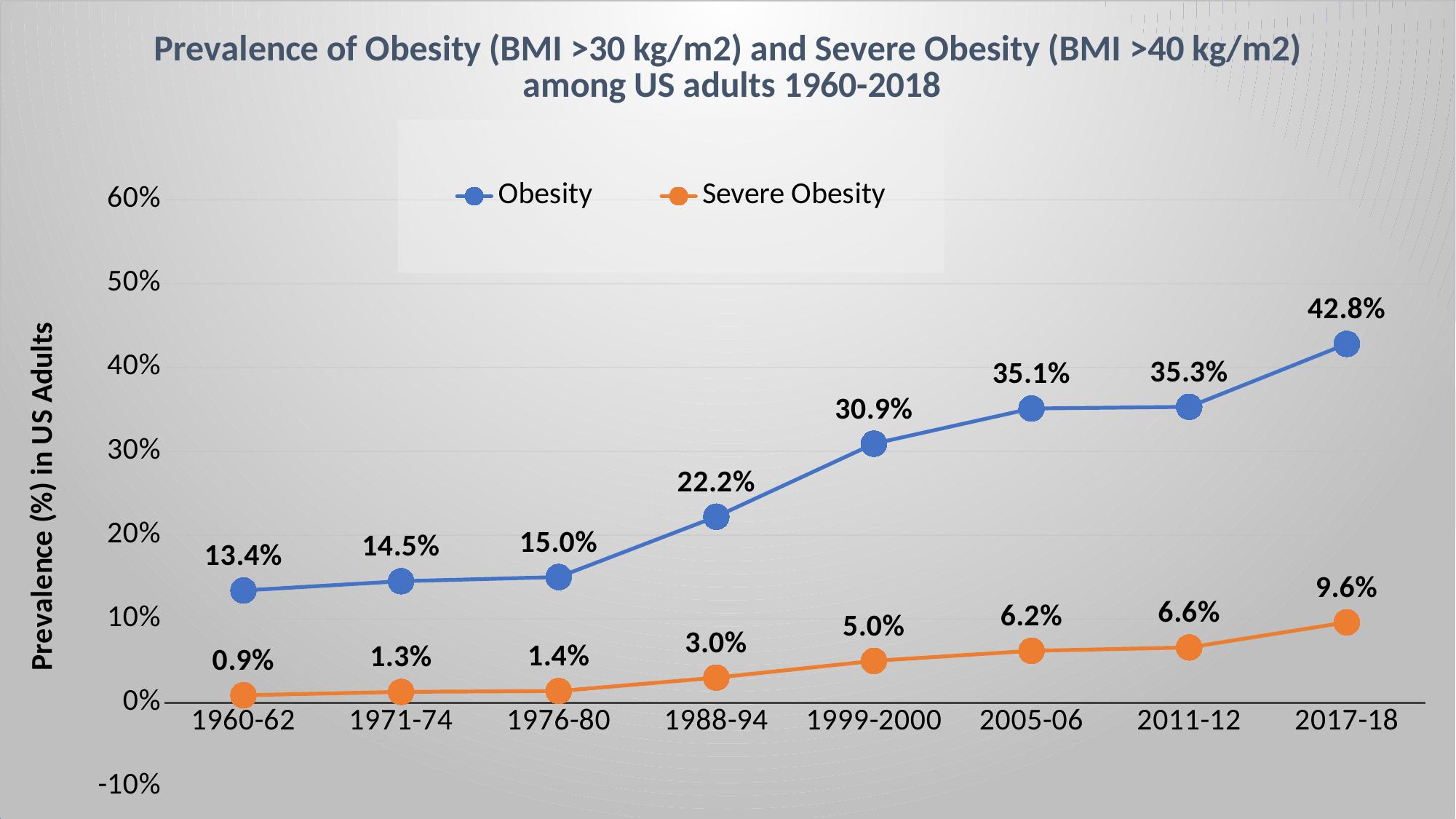
What is the Severe Obesity prevalence for 1988-94? 3.0% Does the Severe Obesity prevalence rise or fall from 1960-62 to 2017-18? Rise Which period has the highest Obesity prevalence? 2017-18 What is the difference between the Obesity and Severe Obesity prevalence in 2017-18? 33.2% What is the Obesity prevalence for 1999-2000? 30.9% Which period has the lowest Severe Obesity prevalence? 1960-62 Which is larger, the Obesity prevalence in 2005-06 or in 1988-94? 2005-06 What kind of chart is shown on the slide? Line chart How many series does the legend list? 2 How many time periods are shown on the x axis? 8 By how much did Obesity prevalence increase from 1976-80 to 1988-94? 7.2% What is the Obesity prevalence for 2017-18? 42.8%